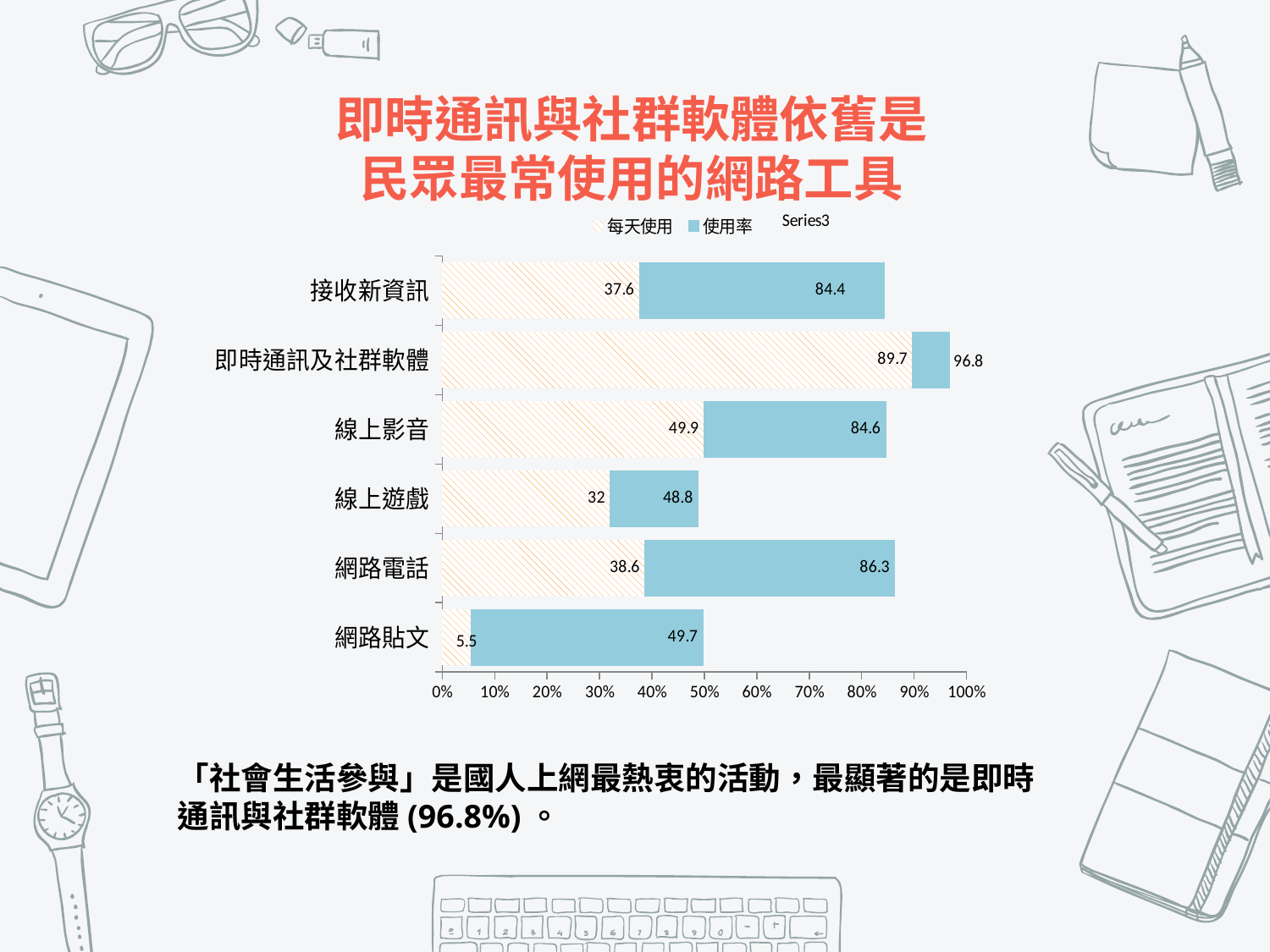
What is the 每天使用 value for 網路貼文? 5.5 What is the 每天使用 value for 線上遊戲? 32 What kind of chart is shown on the slide? Bar chart What is the difference between the 使用率 and 每天使用 values for 網路電話? 47.7 Which has the larger 使用率 value, 線上影音 or 線上遊戲? 線上影音 What is the 使用率 value for 網路電話? 86.3 Which category has the highest 使用率 value? 即時通訊及社群軟體 How many categories are shown on the chart? 6 What is the difference between the 使用率 and 每天使用 values for 即時通訊及社群軟體? 7.1 What is the 使用率 value for 即時通訊及社群軟體? 96.8 Which category has the lowest 使用率 value? 線上遊戲 Which category has the lowest 每天使用 value? 網路貼文